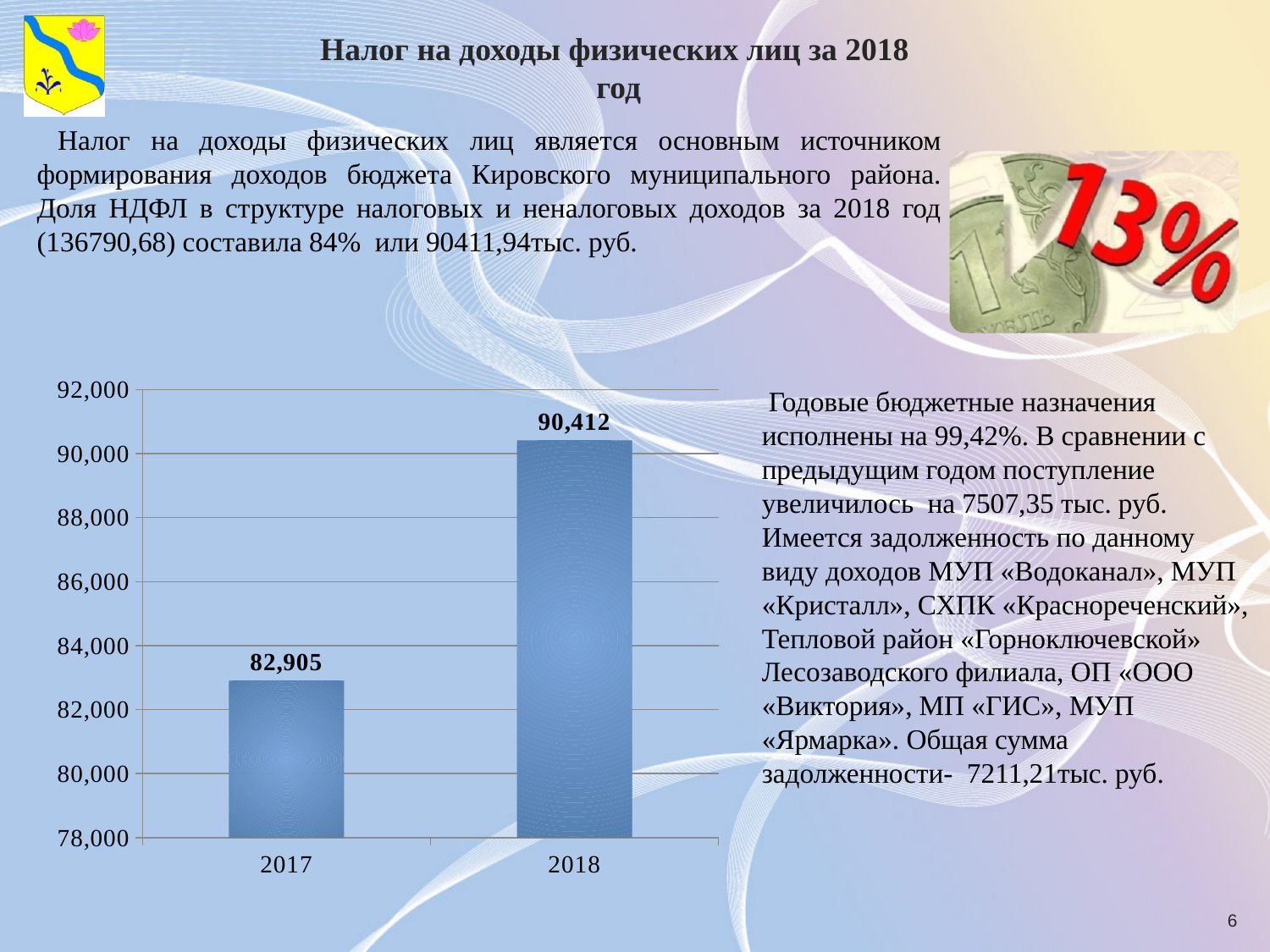
What is the value shown for 2018 in the bar chart? 90,412 Which year has the lower value in the bar chart? 2017 Is the value for 2017 greater or less than 84,000? less What kind of chart is shown on the slide? bar chart What is the value shown for 2017 in the bar chart? 82,905 Which year has the higher value in the bar chart? 2018 How many bars are plotted in the chart? 2 Is the value for 2018 greater or less than 90,000? greater Do the values rise or fall from 2017 to 2018? rise What is the highest value shown on the chart's vertical axis? 92,000 What is the difference between the 2018 and 2017 values in the bar chart? 7,507 What is the lowest value shown on the chart's vertical axis? 78,000